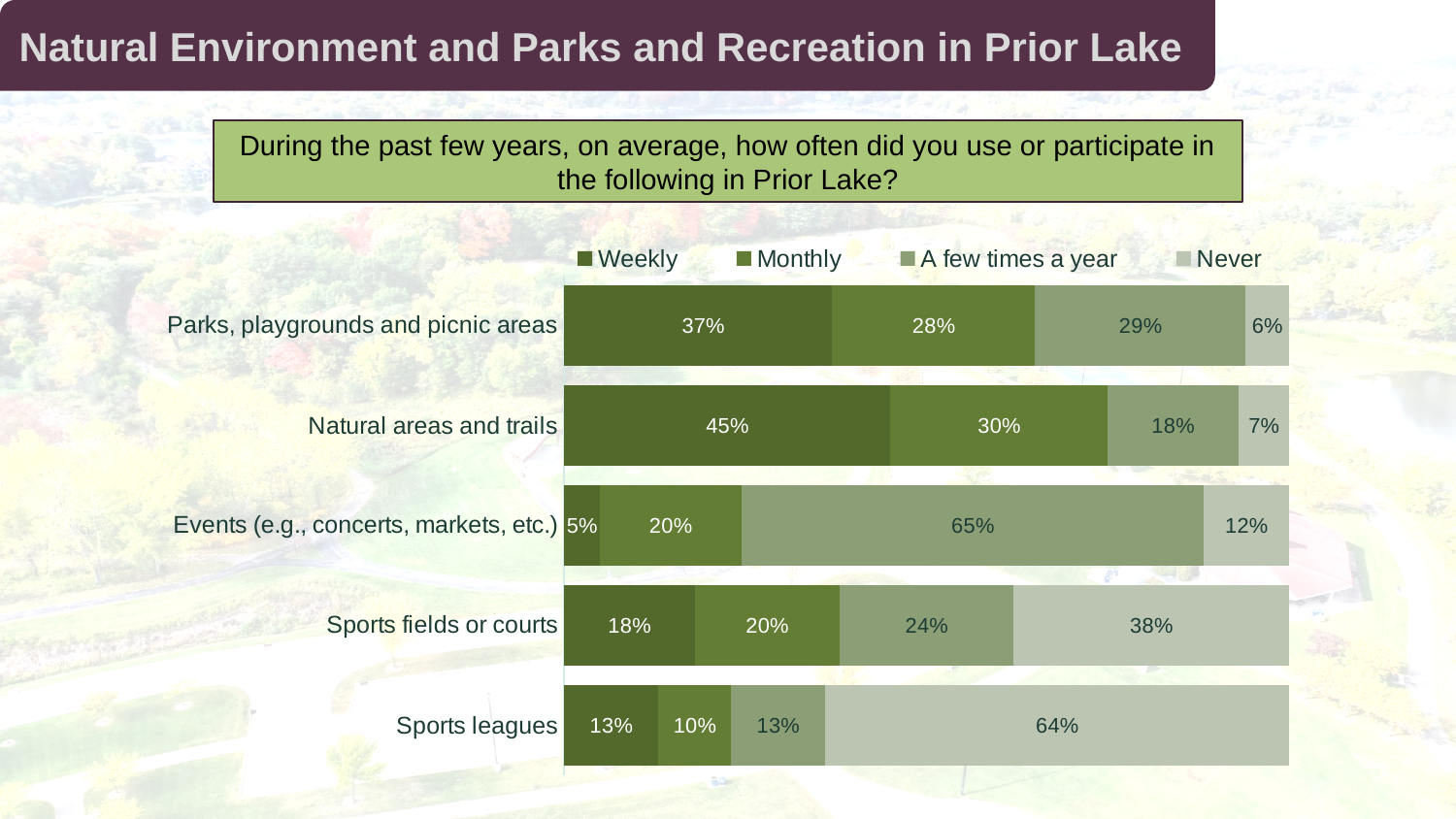
What kind of chart is shown on the slide? Stacked bar chart What percentage of respondents attend events a few times a year? 65% What percentage of respondents use parks, playgrounds and picnic areas weekly? 37% How many categories are shown in the chart? 5 What is the last series listed in the legend? Never Which is larger: the monthly percentage for natural areas and trails or the monthly percentage for sports fields or courts? Natural areas and trails How many series does the legend list? 4 What percentage of respondents never participate in sports leagues? 64% What is the difference between the 'Never' percentages for sports fields or courts and natural areas and trails? 31% Which category has the lowest weekly usage? Events (e.g., concerts, markets, etc.) What is the combined percentage of respondents who use natural areas and trails weekly or monthly? 75% Which category has the highest weekly usage? Natural areas and trails